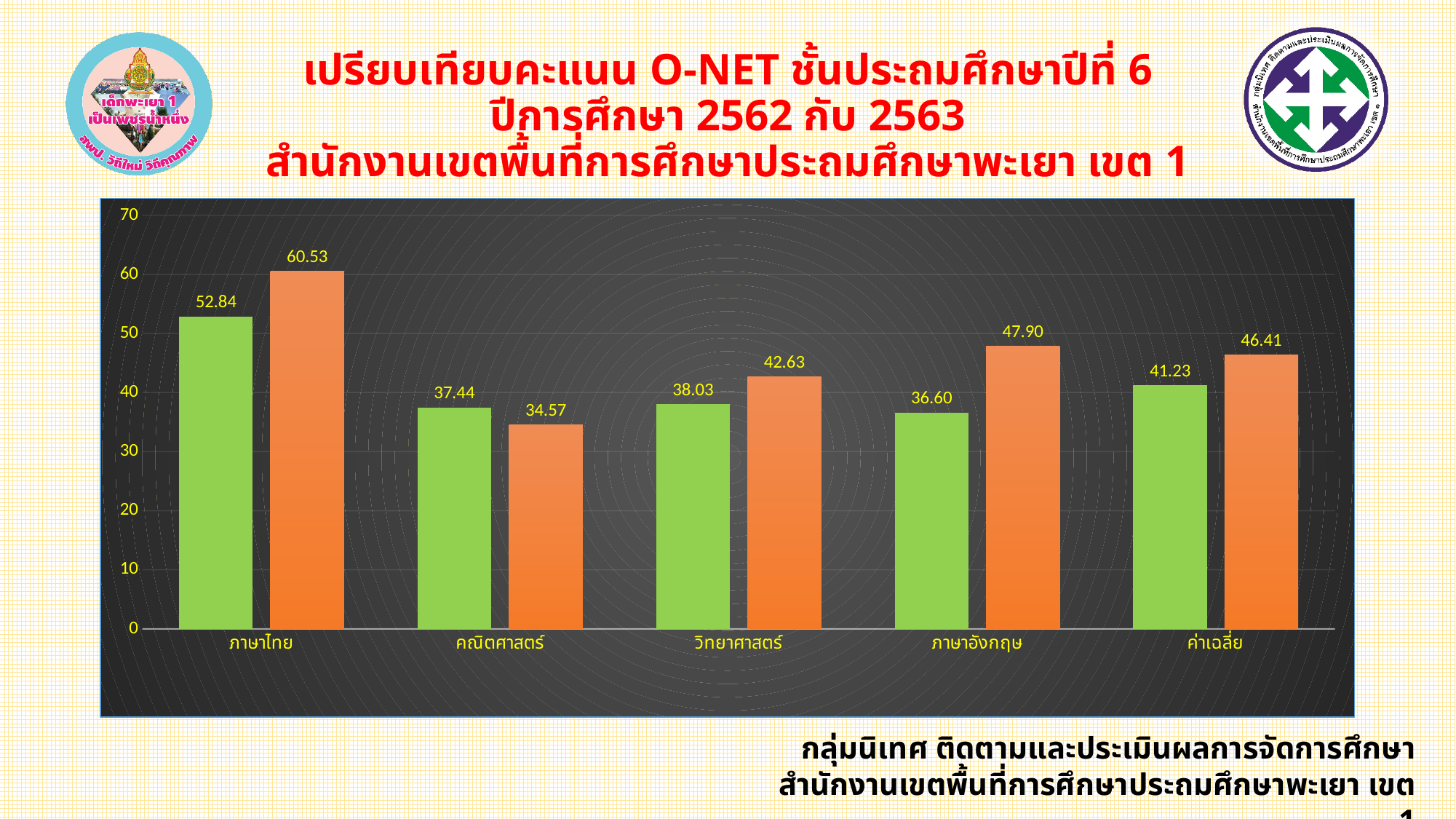
What is the value of the orange bar for ค่าเฉลี่ย? 46.41 Which category has the lowest green bar? ภาษาอังกฤษ What is the difference between the orange bar and the green bar for ภาษาไทย? 7.69 For คณิตศาสตร์, which bar is larger, the green bar or the orange bar? green bar What kind of chart is shown on the slide? bar chart What is the value of the orange bar for ภาษาอังกฤษ? 47.90 What is the difference between the orange bar and the green bar for ภาษาอังกฤษ? 11.30 Which category has the highest orange bar? ภาษาไทย How many categories are shown on the x axis? 5 Is the value of the green bar for วิทยาศาสตร์ greater or less than 40? less Which category has the lowest orange bar? คณิตศาสตร์ What is the value of the green bar for ภาษาไทย? 52.84